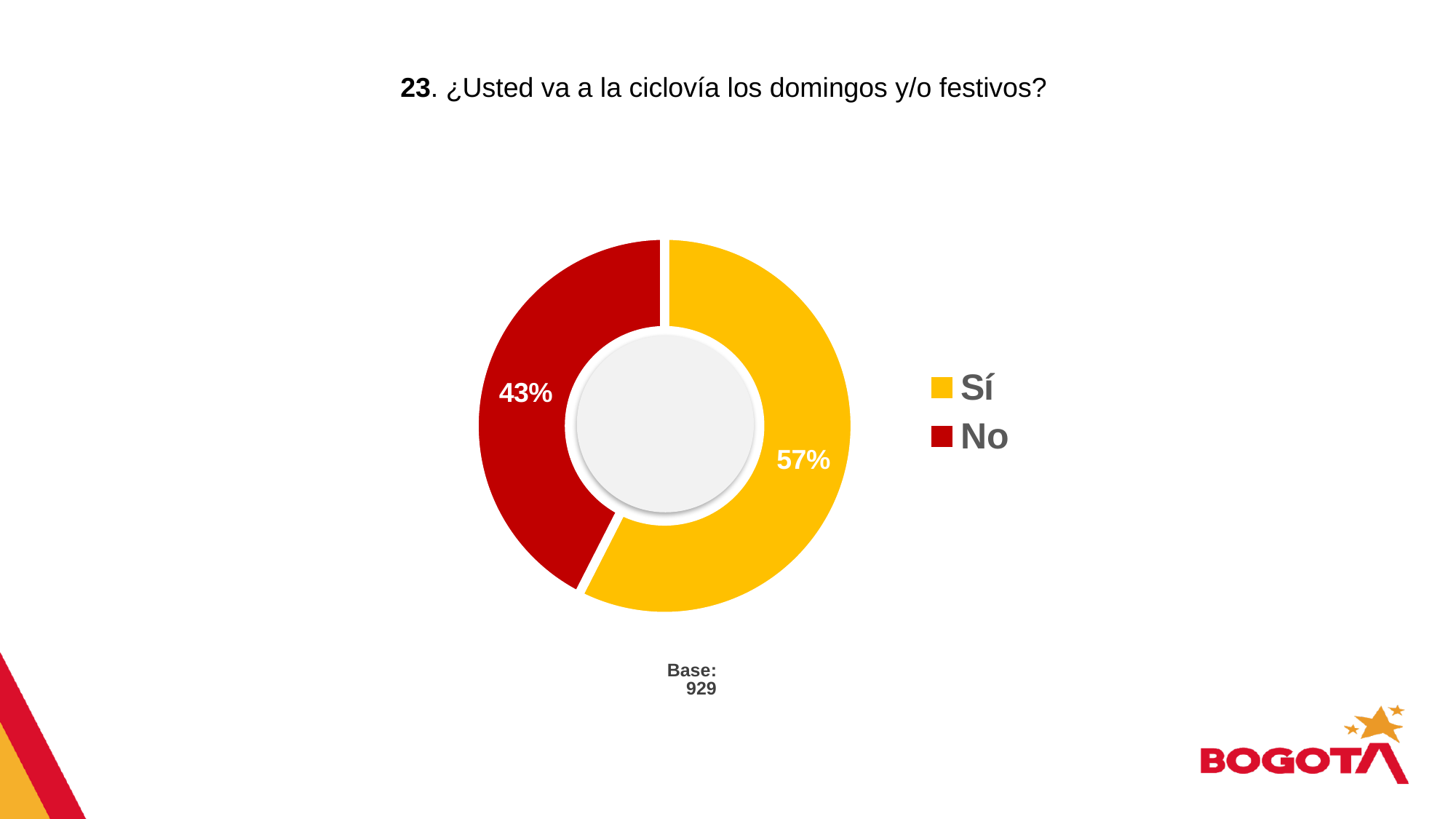
What is the difference in percentage points between the "Sí" and "No" shares? 14 What share of the pie does the "No" slice represent? 43% How many categories does the chart show? 2 What kind of chart is shown on the slide? Pie chart (doughnut) Which is larger, the share for "Sí" or the share for "No"? Sí What percentage of respondents answered "No"? 43% Which response has the smaller share of the chart? No What percentage of respondents answered "Sí"? 57% How many entries does the legend list? 2 What is the base (number of respondents) shown below the chart? 929 Which response has the larger share of the chart? Sí What colour represents the "Sí" response in the chart? Yellow